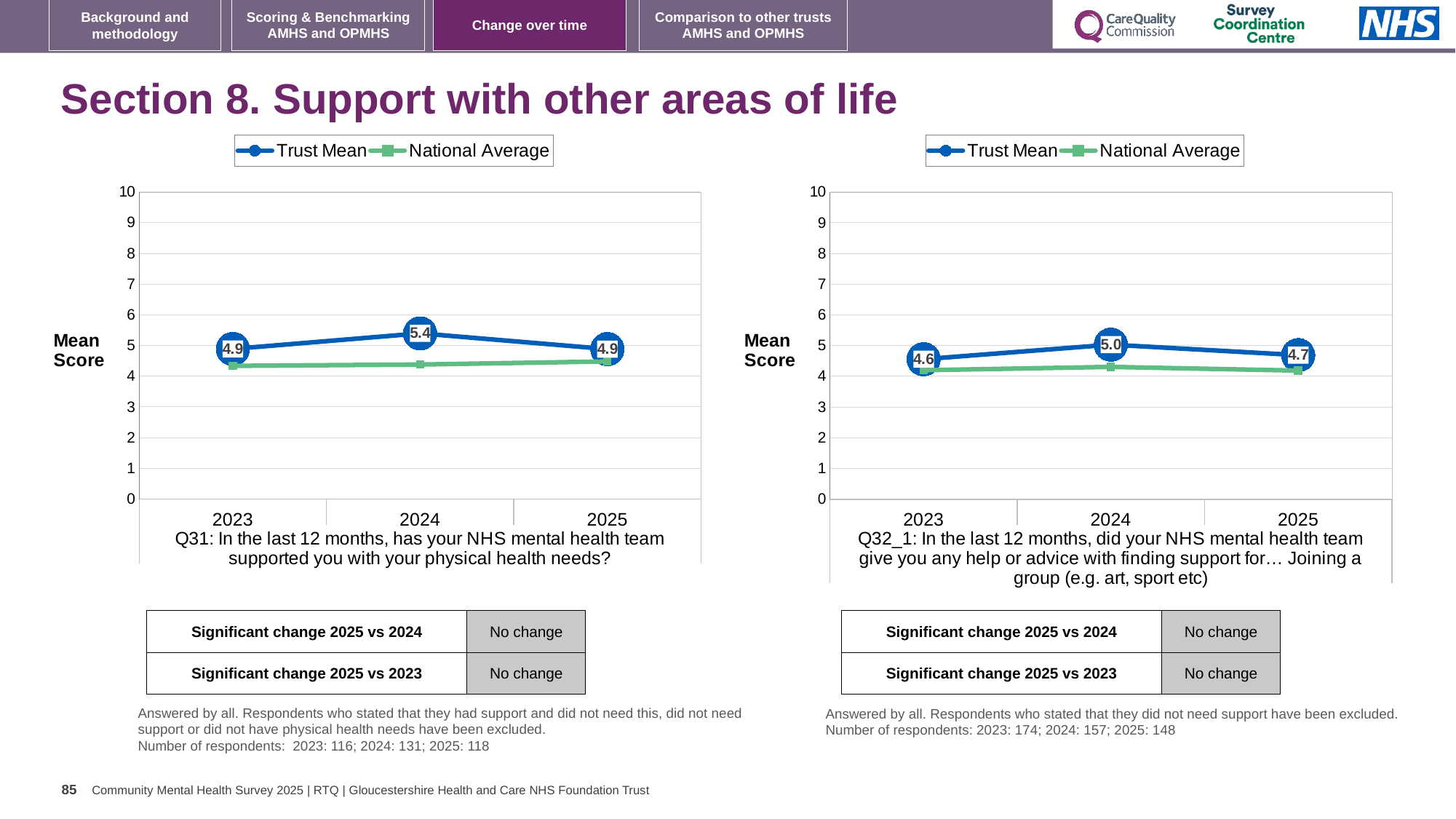
On the right chart (Q32_1), which year has the lowest Trust Mean? 2023 On the right chart (Q32_1), what is the Trust Mean for 2024? 5.0 What type of chart is the right chart (Q32_1)? Line chart On the left chart (Q31), which year has the highest Trust Mean? 2024 On the right chart (Q32_1), what is the Trust Mean for 2023? 4.6 How many years are shown on the x axis of the right chart (Q32_1)? 3 How many series does the legend of the left chart (Q31) list? 2 On the left chart (Q31), what is the Trust Mean for 2024? 5.4 On the left chart (Q31), what is the Trust Mean for 2025? 4.9 On the left chart (Q31), is the National Average for 2023 greater or less than 5? less On the right chart (Q32_1), which is larger, the Trust Mean for 2024 or for 2025? 2024 On the left chart (Q31), what is the difference between the Trust Mean in 2024 and in 2025? 0.5